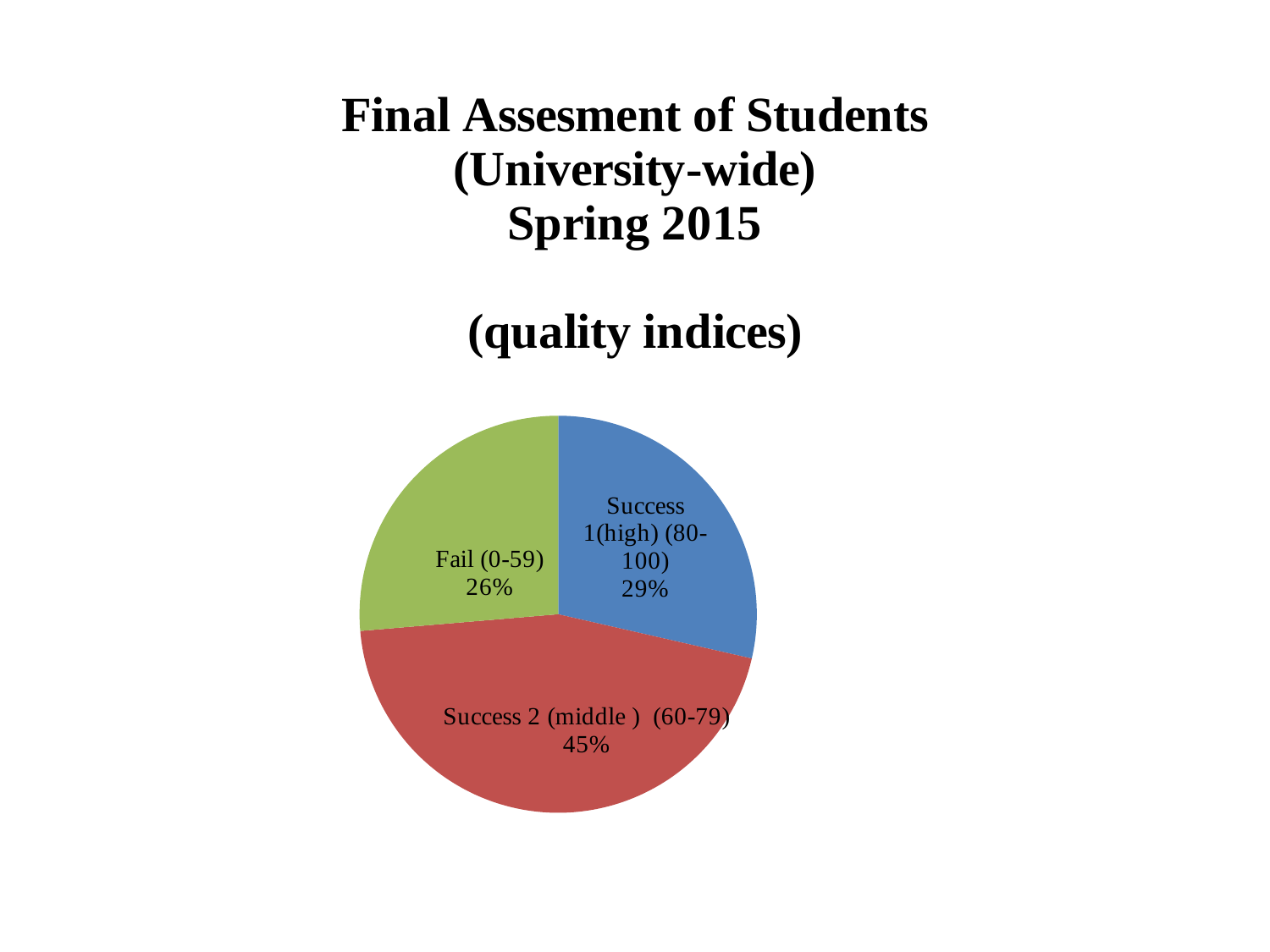
What is the difference in percentage points between the Success 1(high) slice and the Fail slice? 3 Which is larger, the Success 1(high) (80-100) slice or the Fail (0-59) slice? Success 1(high) (80-100) What is the difference in percentage points between the Success 2 (middle) slice and the Fail slice? 19 What share of the pie does the Success 1(high) (80-100) slice represent? 29% What share of the pie does the Fail (0-59) slice represent? 26% Which category has the smallest slice of the pie? Fail (0-59) What is the title of the chart? Final Assesment of Students (University-wide) Spring 2015 (quality indices) What kind of chart is shown on the slide? pie chart Which category has the largest slice of the pie? Success 2 (middle) (60-79) What share of the pie does the Success 2 (middle) (60-79) slice represent? 45% How many slices does the pie chart have? 3 What colour is the Success 2 (middle) (60-79) slice? red